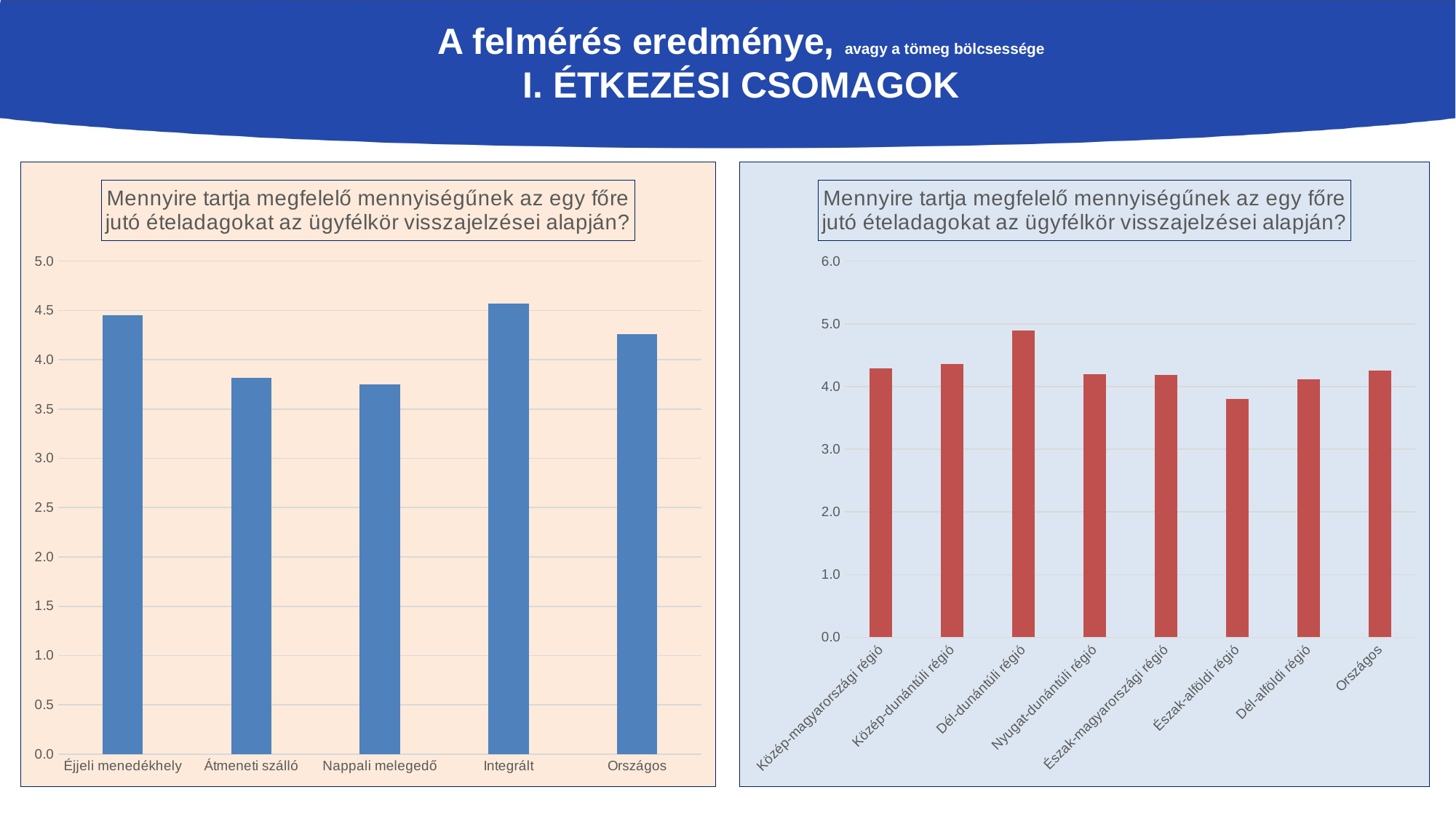
What colour are the bars on the right chart? red On the left chart, which is larger: the value for Integrált or the value for Átmeneti szálló? Integrált On the left chart, is the value for Éjjeli menedékhely greater or less than 4.0? greater How many categories are shown on the right chart? 8 On the right chart, which region has the highest value? Dél-dunántúli régió On the left chart, which category has the highest value? Integrált On the right chart, is the value for Dél-dunántúli régió greater or less than 4.5? greater On the right chart, which region has the lowest value? Észak-alföldi régió On the left chart, is the value for Nappali melegedő greater or less than 4.0? less How many categories are shown on the left chart? 5 What kind of chart is the left chart on the slide? bar chart